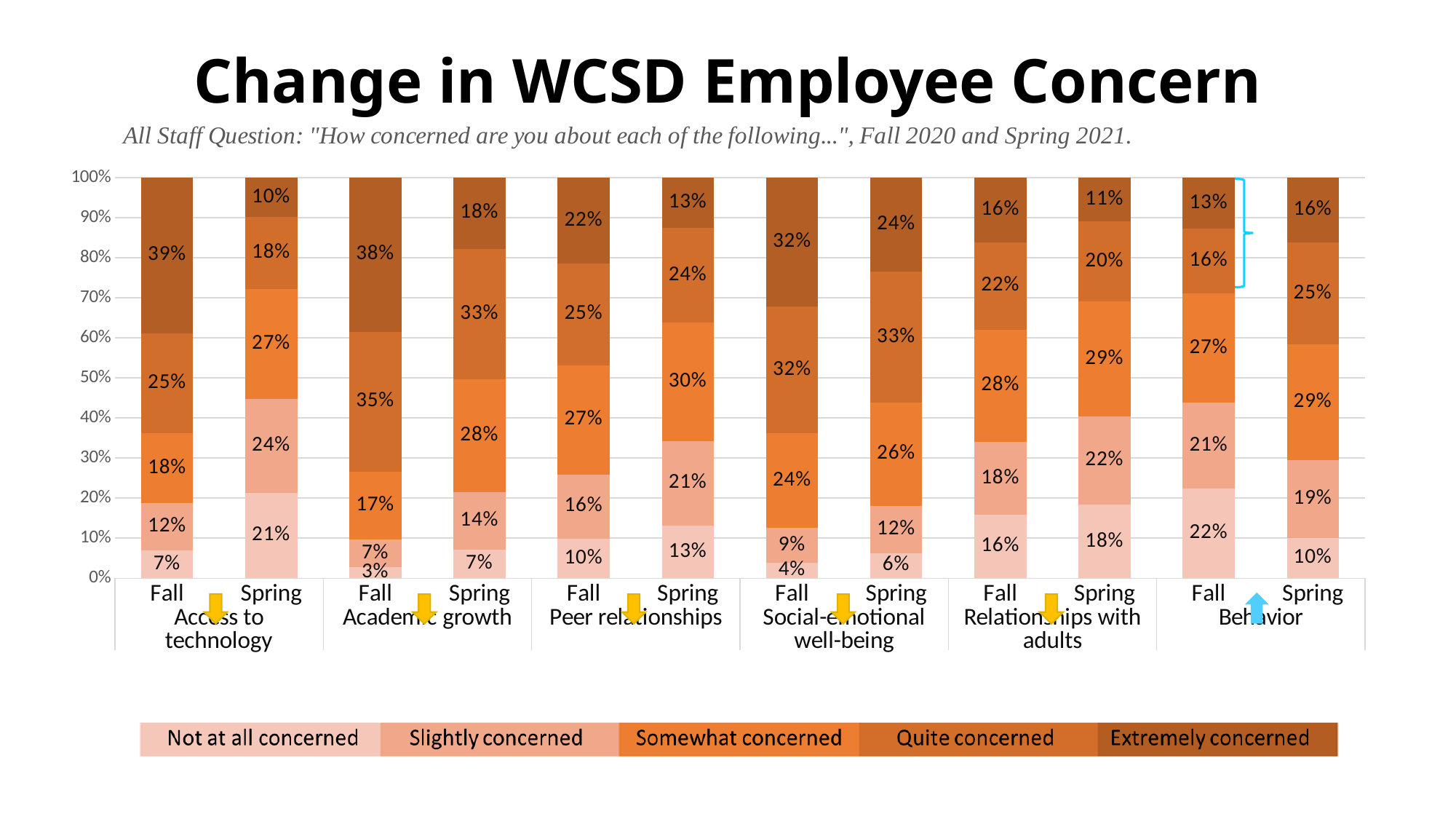
Which bar has the highest Extremely concerned share? Access to technology Fall What kind of chart is shown on the slide? Stacked bar chart How many series does the legend list? 5 Which legend entry is shown in the darkest colour? Extremely concerned Which is larger: the Not at all concerned share for Behavior in Fall or in Spring? Fall What percentage of staff were Extremely concerned about Access to technology in Fall? 39% What percentage of staff were Quite concerned about Academic growth in Spring? 33% How many bars are plotted in the chart? 12 What percentage of staff were Not at all concerned about Behavior in Spring? 10% What percentage of staff were Somewhat concerned about Peer relationships in Fall? 27% Which bar has the lowest Not at all concerned share? Academic growth Fall What is the difference between the Extremely concerned share for Academic growth in Fall and in Spring? 20%